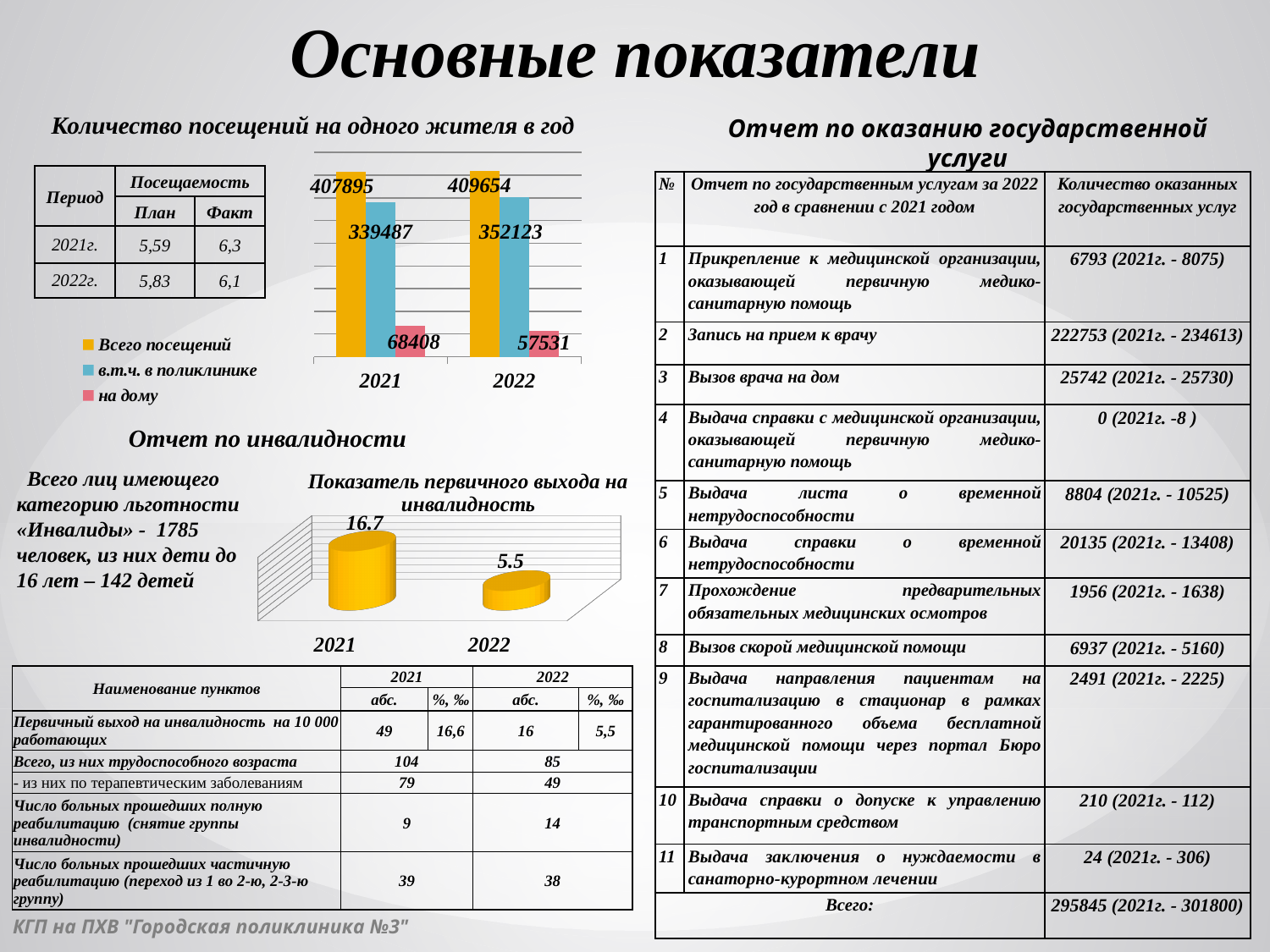
In the visits bar chart at the top left of the slide, what is the difference between the 'на дому' values for 2021 and 2022? 10877 In the visits bar chart at the top left of the slide, which series has the lowest value in 2022? на дому In the chart titled 'Показатель первичного выхода на инвалидность', what is the value for 2021? 16.7 In the chart titled 'Показатель первичного выхода на инвалидность', what is the value for 2022? 5.5 In the visits bar chart at the top left of the slide, how many series does the legend list? 3 In the visits bar chart at the top left of the slide, what is the value of 'в т.ч. в поликлинике' for 2022? 352123 In the visits bar chart at the top left of the slide, what is the value of 'на дому' for 2021? 68408 In the visits bar chart at the top left of the slide, what is the value of 'Всего посещений' for 2021? 407895 In the chart titled 'Показатель первичного выхода на инвалидность', does the value rise or fall from 2021 to 2022? Fall In the visits bar chart at the top left of the slide, what colour are the 'Всего посещений' bars? Yellow In the visits bar chart at the top left of the slide, is the 'Всего посещений' value larger in 2021 or in 2022? 2022 In the chart titled 'Показатель первичного выхода на инвалидность', what is the difference between the 2021 and 2022 values? 11.2